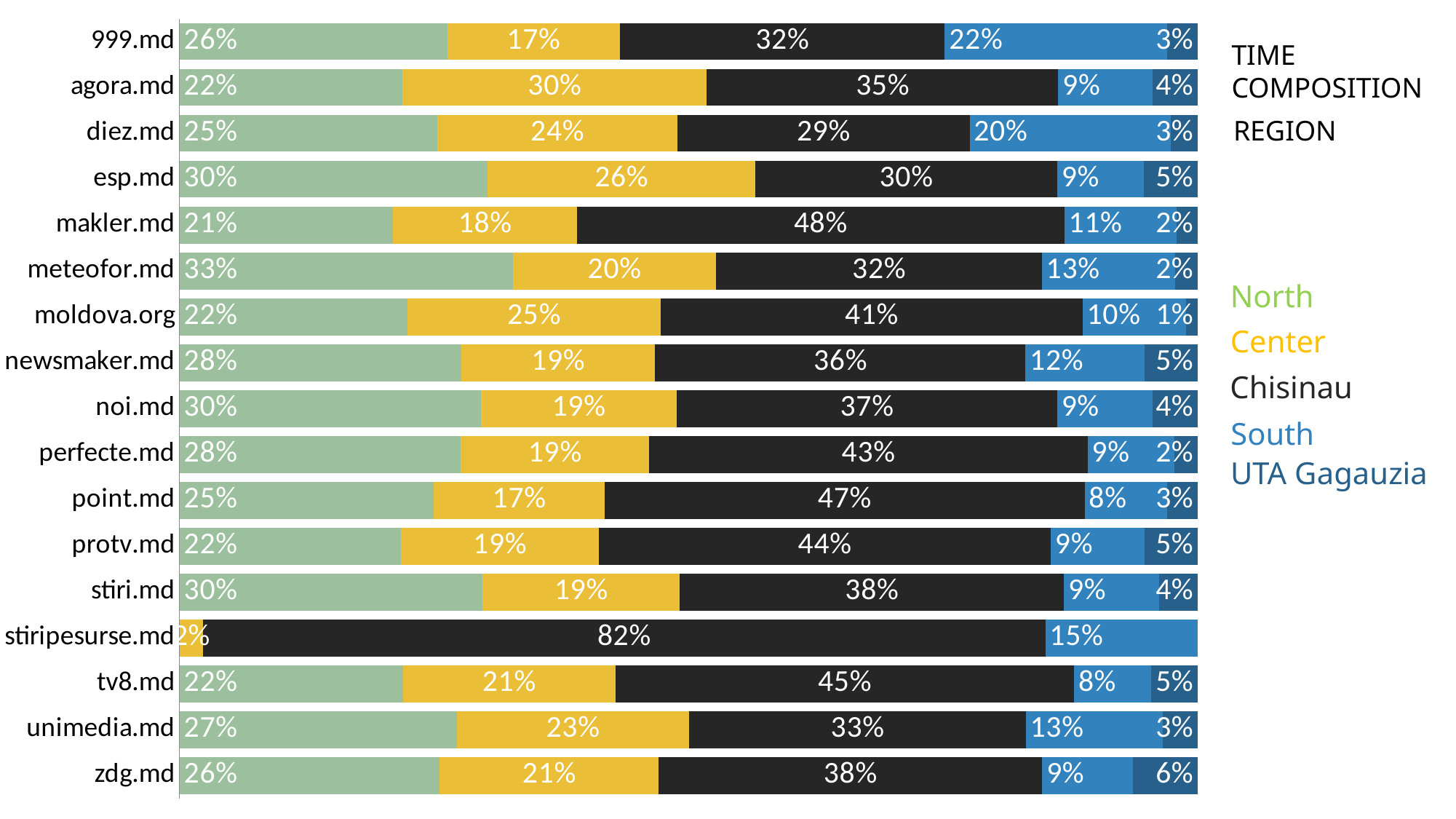
How many regions does the legend list? 5 What is the difference between the South share of 999.md and the South share of agora.md? 13% Which website has the highest North share? meteofor.md Which website has the highest Chisinau share? stiripesurse.md What is the total of the stacked bar for 999.md? 100% What is the North share for meteofor.md? 33% Which has a larger Center share, agora.md or esp.md? agora.md What percentage of time for makler.md comes from Chisinau? 48% What is the UTA Gagauzia share for zdg.md? 6% How many websites are shown in the chart? 17 What type of chart is shown on the slide? Stacked bar chart Which website has the lowest Chisinau share? diez.md